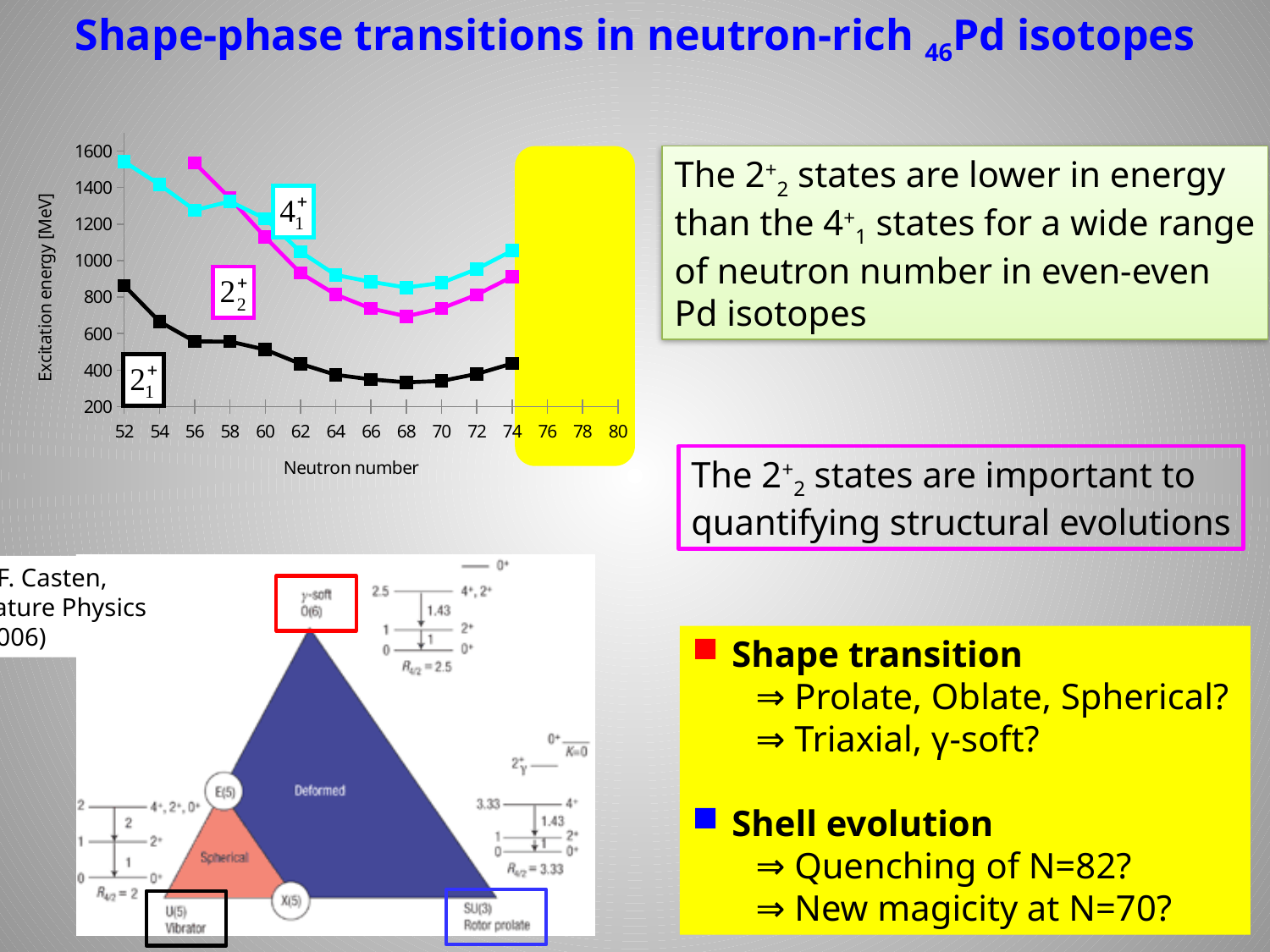
In the excitation energy chart, what is the label of the y axis? Excitation energy [MeV] In the excitation energy chart, is the value of the 2+2 series at neutron number 68 greater or less than 800? less In the excitation energy chart, what is the label of the x axis? Neutron number In the excitation energy chart, at neutron number 68, which is higher: the 4+1 series or the 2+2 series? 4+1 In the excitation energy chart, how many neutron-number tick labels are shown on the x axis? 15 What kind of chart is the plot of excitation energy versus neutron number? line chart In the excitation energy chart, which series has the lowest excitation energy across the plotted neutron numbers? 2+1 In the excitation energy chart, is the value of the 4+1 series at neutron number 52 greater or less than 1400? greater In the excitation energy chart, does the 2+1 series rise or fall as the neutron number increases from 52 to 68? fall In the excitation energy chart, is the value of the 2+1 series at neutron number 68 greater or less than 400? less How many labelled series (states) are plotted in the excitation energy chart? 3